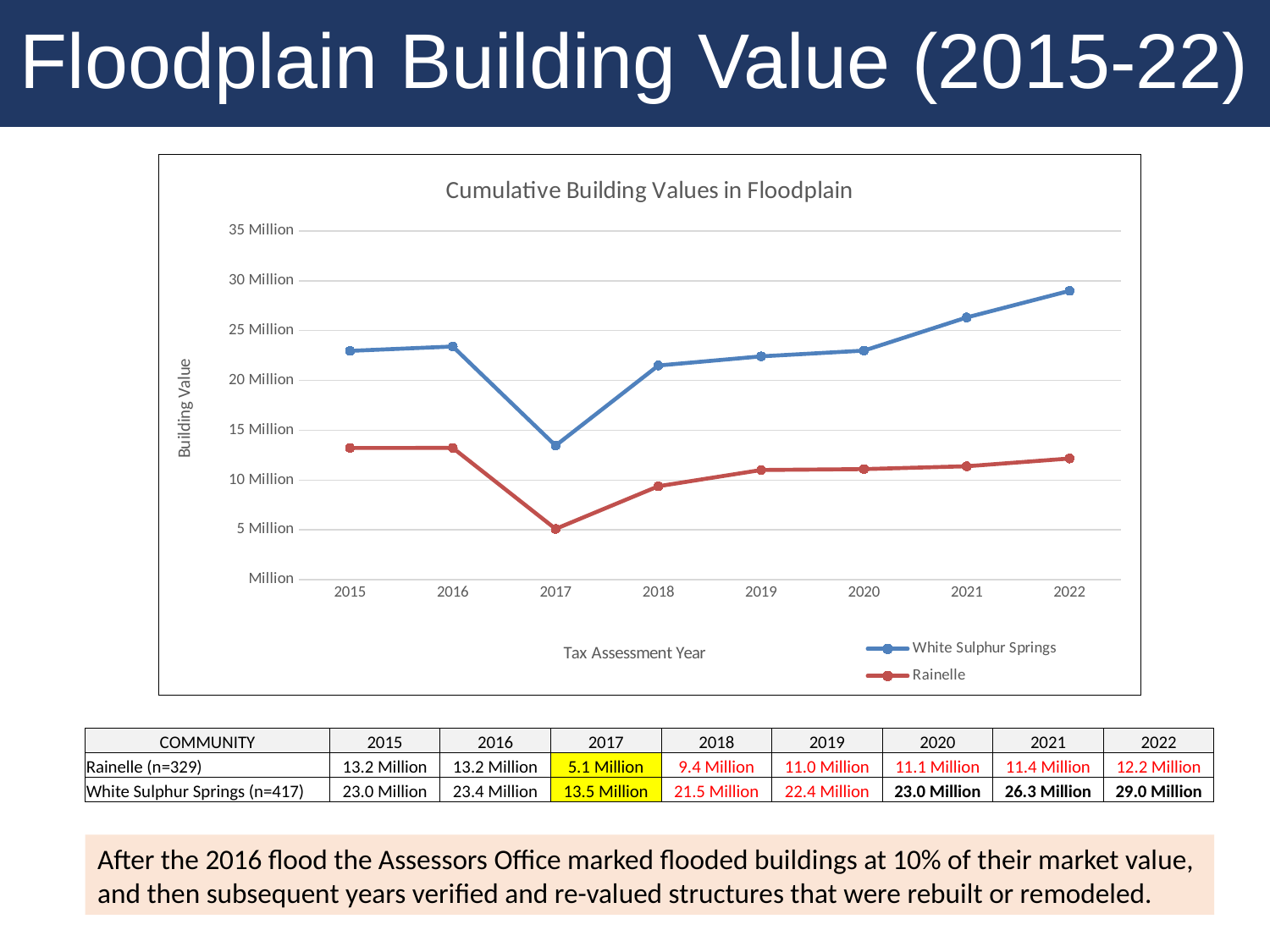
Does the Rainelle building value rise or fall from 2017 to 2022? rise What is the difference between the White Sulphur Springs and Rainelle building values in 2022? 16.8 Million How many series does the chart legend list? 2 What is the building value for Rainelle in 2017? 5.1 Million Is the White Sulphur Springs building value in 2021 greater or less than 25 Million? greater What is the title of the chart? Cumulative Building Values in Floodplain How many years are plotted along the x axis of the chart? 8 What kind of chart is shown on the slide? line chart Which community has the larger building value in 2018, White Sulphur Springs or Rainelle? White Sulphur Springs In which year is the White Sulphur Springs building value lowest? 2017 What is the building value for White Sulphur Springs in 2022? 29.0 Million